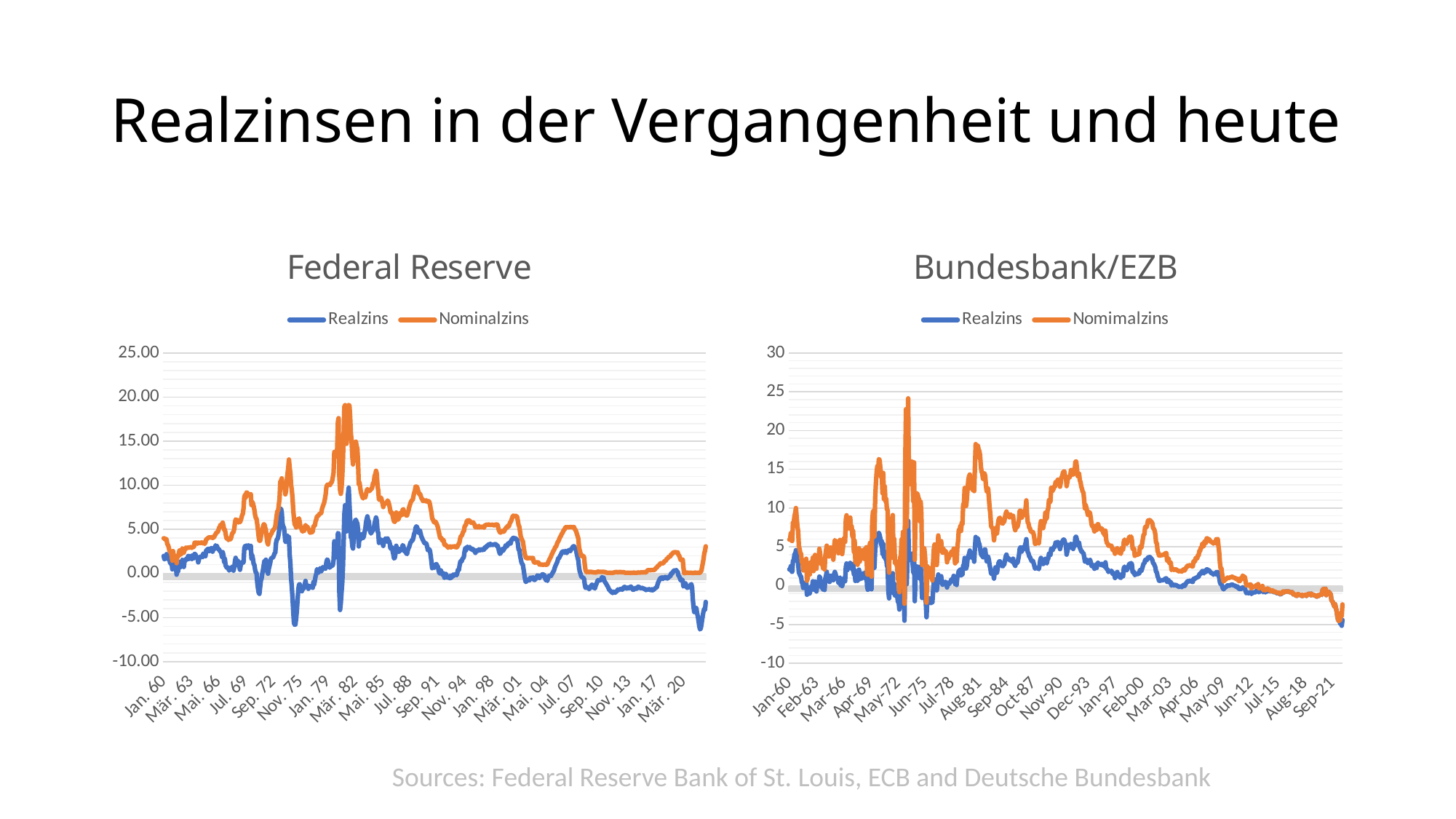
What is the highest value shown on the y axis of the Bundesbank/EZB chart? 30 In the Bundesbank/EZB chart, does Nomimalzins generally rise or fall from the early 1990s to 2021? fall In the Federal Reserve chart, does Nominalzins generally rise or fall from 1982 to 2013? fall How many series does the legend of the Bundesbank/EZB chart list? 2 In the Federal Reserve chart, is the Realzins value around Nov. 75 greater or less than 0.00? less In the Federal Reserve chart, which series reaches the higher peak, Realzins or Nominalzins? Nominalzins What are the two series named in the legend of the Federal Reserve chart? Realzins and Nominalzins In the Bundesbank/EZB chart, is the highest value of Nomimalzins (around 1973) greater or less than 20? greater In the Bundesbank/EZB chart, is the Realzins value at the end of the series (around Sep-21) greater or less than 0? less In the Federal Reserve chart, which series is drawn in orange? Nominalzins What kind of chart is the Federal Reserve chart? line chart